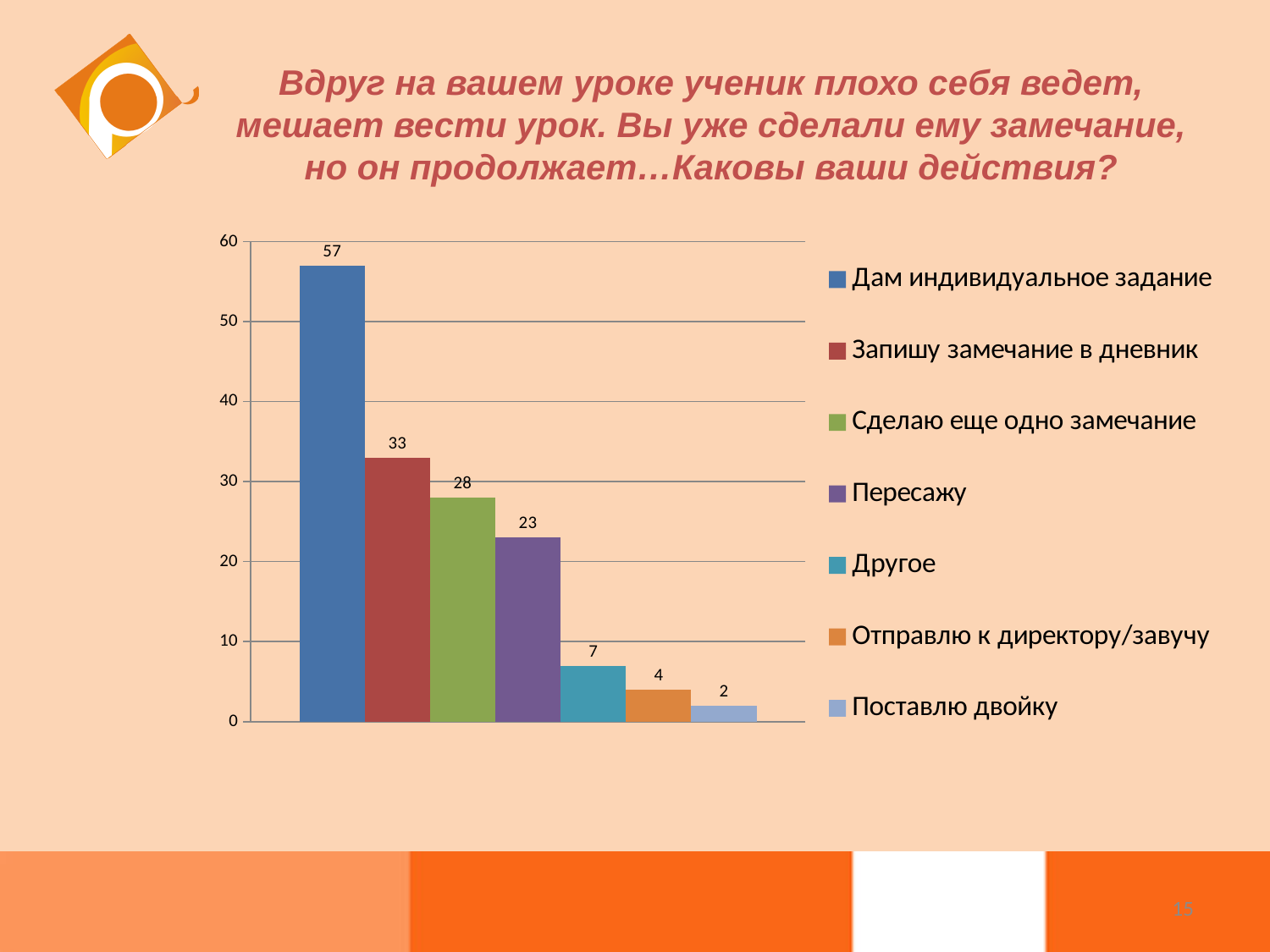
Is the value for "Другое" greater or less than 10? less What is the difference between the values for "Дам индивидуальное задание" and "Запишу замечание в дневник"? 24 What is the value for "Запишу замечание в дневник"? 33 Which category has the highest value? Дам индивидуальное задание What is the value for "Поставлю двойку"? 2 How many categories are shown in the chart? 7 What kind of chart is shown on the slide? bar chart Which is larger: the value for "Сделаю еще одно замечание" or the value for "Пересажу"? Сделаю еще одно замечание What is the value for "Дам индивидуальное задание"? 57 What is the value for "Пересажу"? 23 Which category has the lowest value? Поставлю двойку What colour is the bar for "Отправлю к директору/завучу"? orange